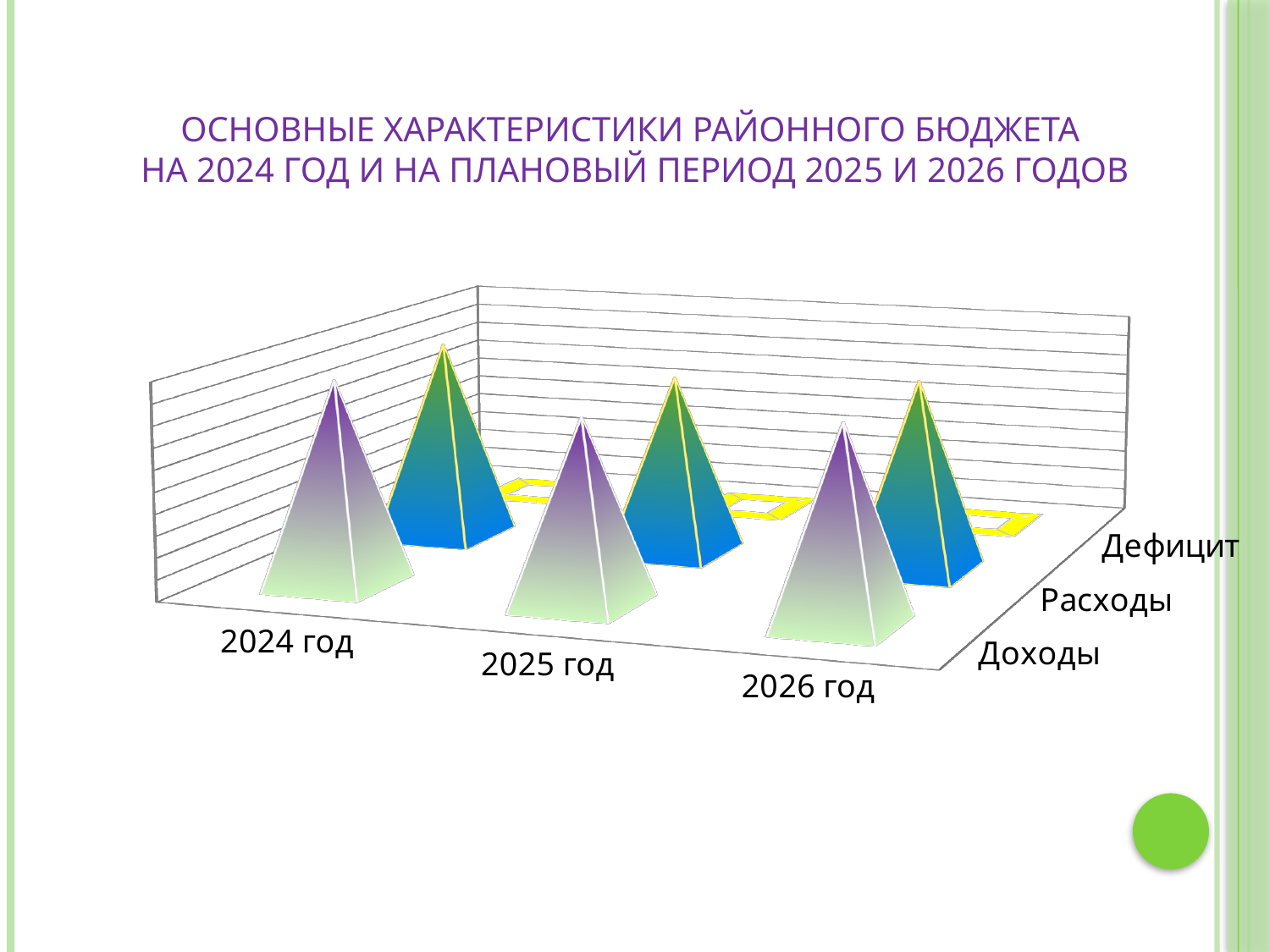
How many data series does the chart show? 3 What is the title of the slide containing the chart? Основные характеристики районного бюджета на 2024 год и на плановый период 2025 и 2026 годов Which series has the lowest value for 2024 год? Дефицит For 2024 год, which is larger: Расходы or Дефицит? Расходы How many year categories are shown along the x axis of the chart? 3 What are the names of the three series shown in the chart? Доходы, Расходы, Дефицит For 2025 год, which is larger: Доходы or Дефицит? Доходы What kind of chart is shown on the slide? bar chart Which series has the lowest value for 2026 год? Дефицит Which year categories are shown on the chart? 2024 год, 2025 год, 2026 год